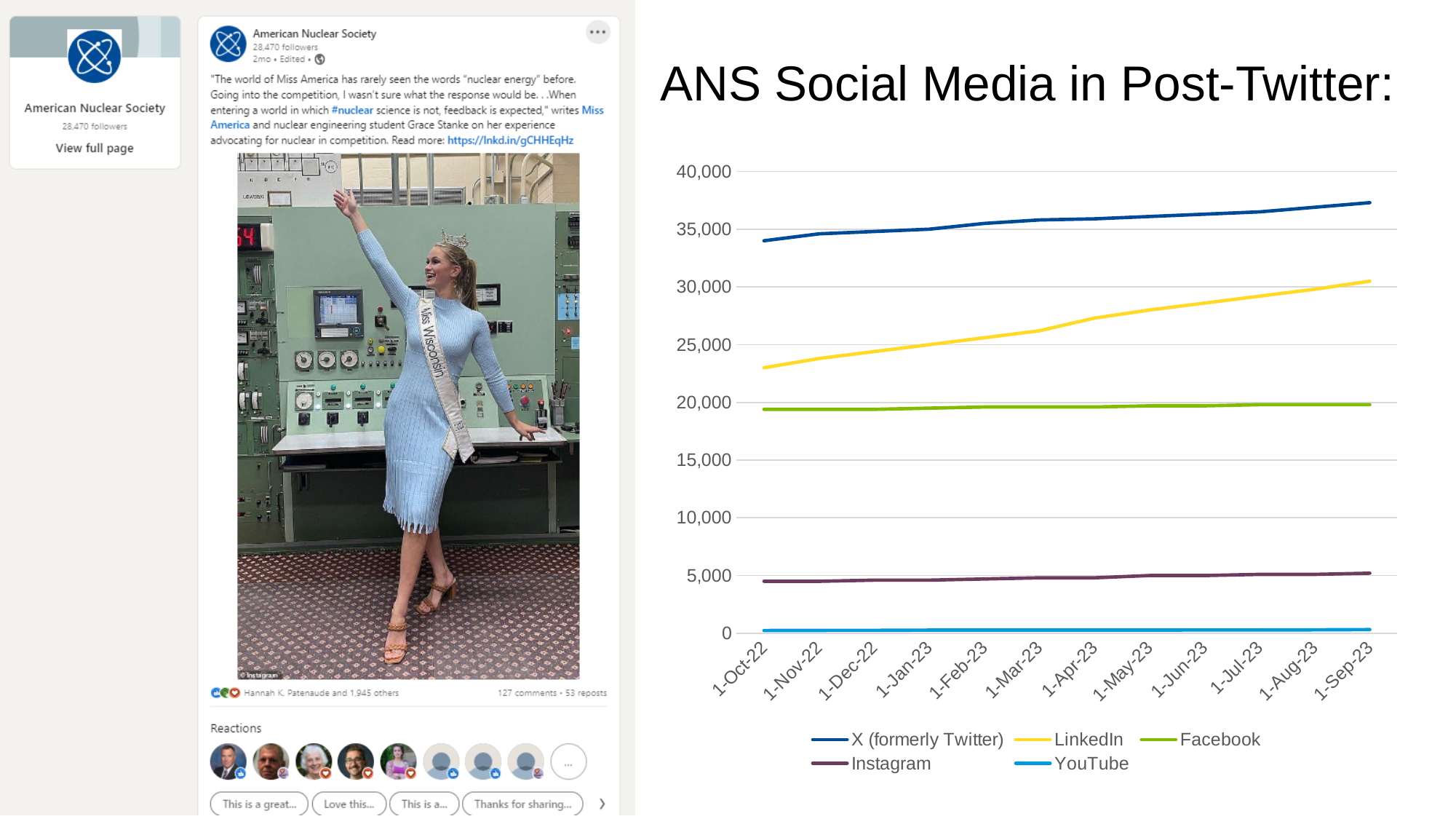
What kind of chart is shown on the slide? line chart How many dates are shown along the x axis of the chart? 12 Is the value for X (formerly Twitter) on 1-Sep-23 greater or less than 35,000? greater On 1-Sep-23, which is larger: the value for LinkedIn or the value for Facebook? LinkedIn How many series does the chart's legend list? 5 Do the values for LinkedIn rise or fall from 1-Oct-22 to 1-Sep-23? rise What is the title of the chart on the slide? ANS Social Media in Post-Twitter: Is the value for LinkedIn on 1-Oct-22 greater or less than 25,000? less Is the value for X (formerly Twitter) on 1-Oct-22 greater or less than 35,000? less Which series has the highest values throughout the chart? X (formerly Twitter) Which series has the lowest values throughout the chart? YouTube